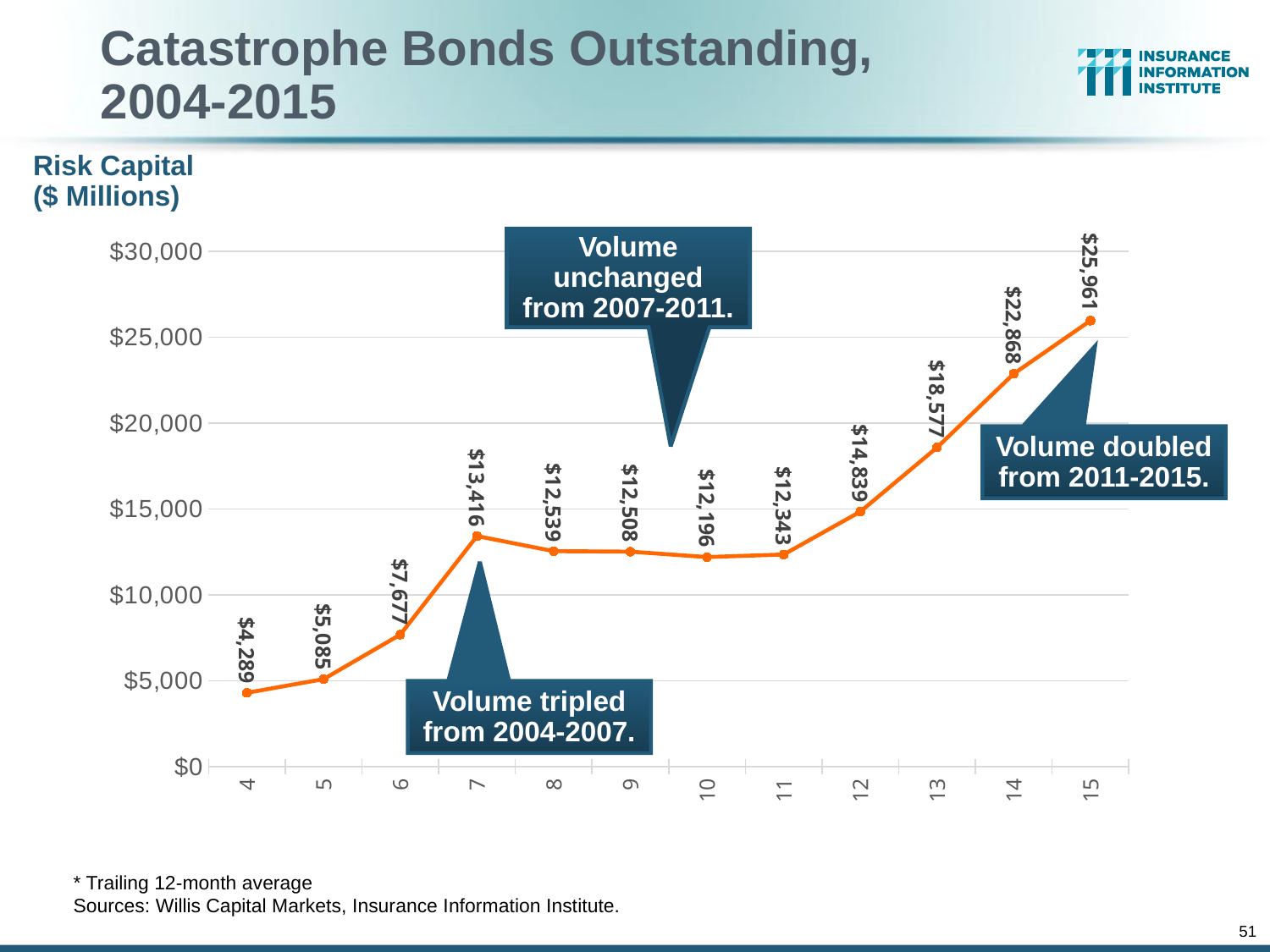
What is the value for the point labeled 7 (2007)? $13,416 Which x-axis point has the lowest value? 4 How many data points are plotted on the line? 12 What does the callout pointing at the 2015 point say? Volume doubled from 2011-2015. What is the value for the point labeled 11 (2011)? $12,343 What is the difference between the values at point 14 and point 13? $4,291 What is the value for the point labeled 15 (2015)? $25,961 Which x-axis point has the highest value? 15 What is the value for the point labeled 4 (2004)? $4,289 What is the difference between the values at point 15 and point 4? $21,672 What type of chart is shown on the slide? line chart Which is larger, the value at point 7 or the value at point 8? point 7